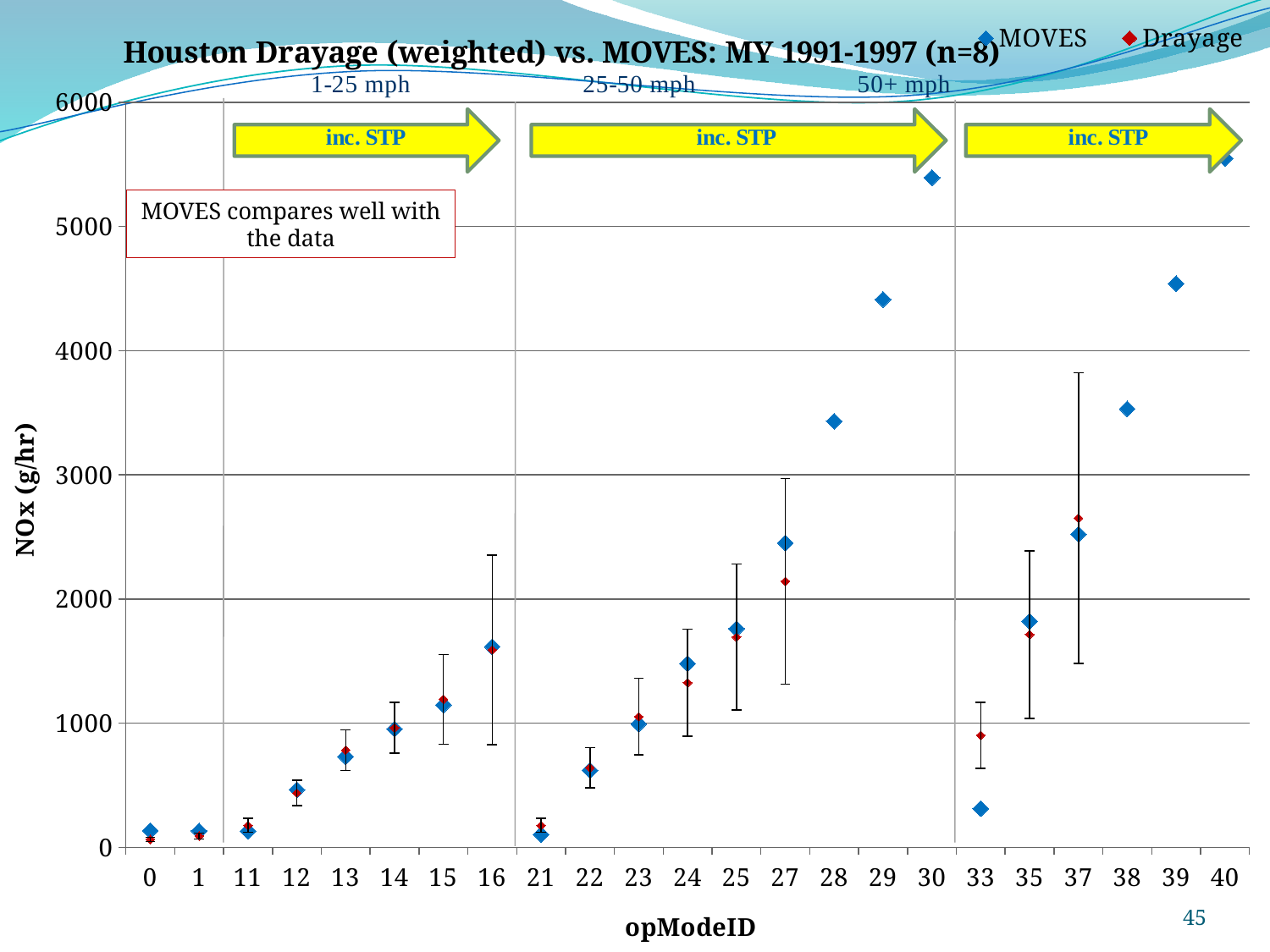
What are the two series named in the legend? MOVES and Drayage Do the MOVES values rise or fall from opModeID 21 to opModeID 30? rise Is the MOVES value for opModeID 28 greater or less than 3000? greater What is the title of the y axis? NOx (g/hr) Which is larger, the MOVES value for opModeID 29 or for opModeID 38? opModeID 29 How many opModeID categories are shown on the x axis? 23 Is the MOVES value for opModeID 30 greater or less than 5000? greater Is the MOVES value for opModeID 33 greater or less than 1000? less Which opModeID has the highest Drayage value? 37 What kind of chart is shown on the slide? scatter chart How many series does the legend list? 2